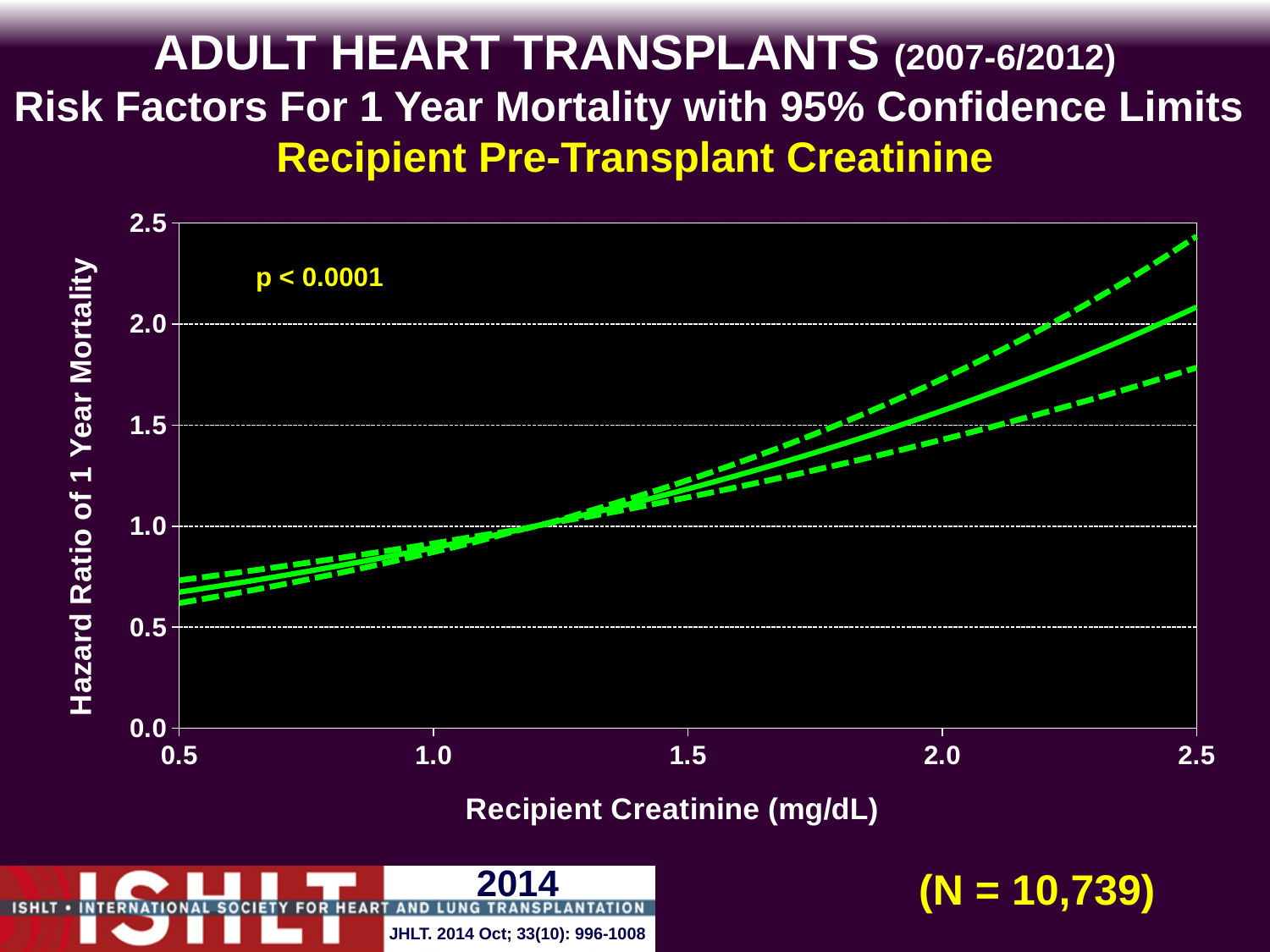
Is the upper 95% confidence limit (upper dashed line) at a recipient creatinine of 2.5 mg/dL greater or less than 2.0? greater Is the lower 95% confidence limit (lower dashed line) at a recipient creatinine of 2.5 mg/dL greater or less than 2.0? less Is the hazard ratio (solid line) at a recipient creatinine of 0.5 mg/dL greater or less than 1.0? less What p-value is printed on the chart? p < 0.0001 Does the hazard ratio of 1 year mortality rise or fall as recipient creatinine increases from 0.5 to 2.5 mg/dL? rise What kind of chart is shown on the slide? line chart How many lines are plotted on the chart? 3 What is the label of the x axis? Recipient Creatinine (mg/dL)